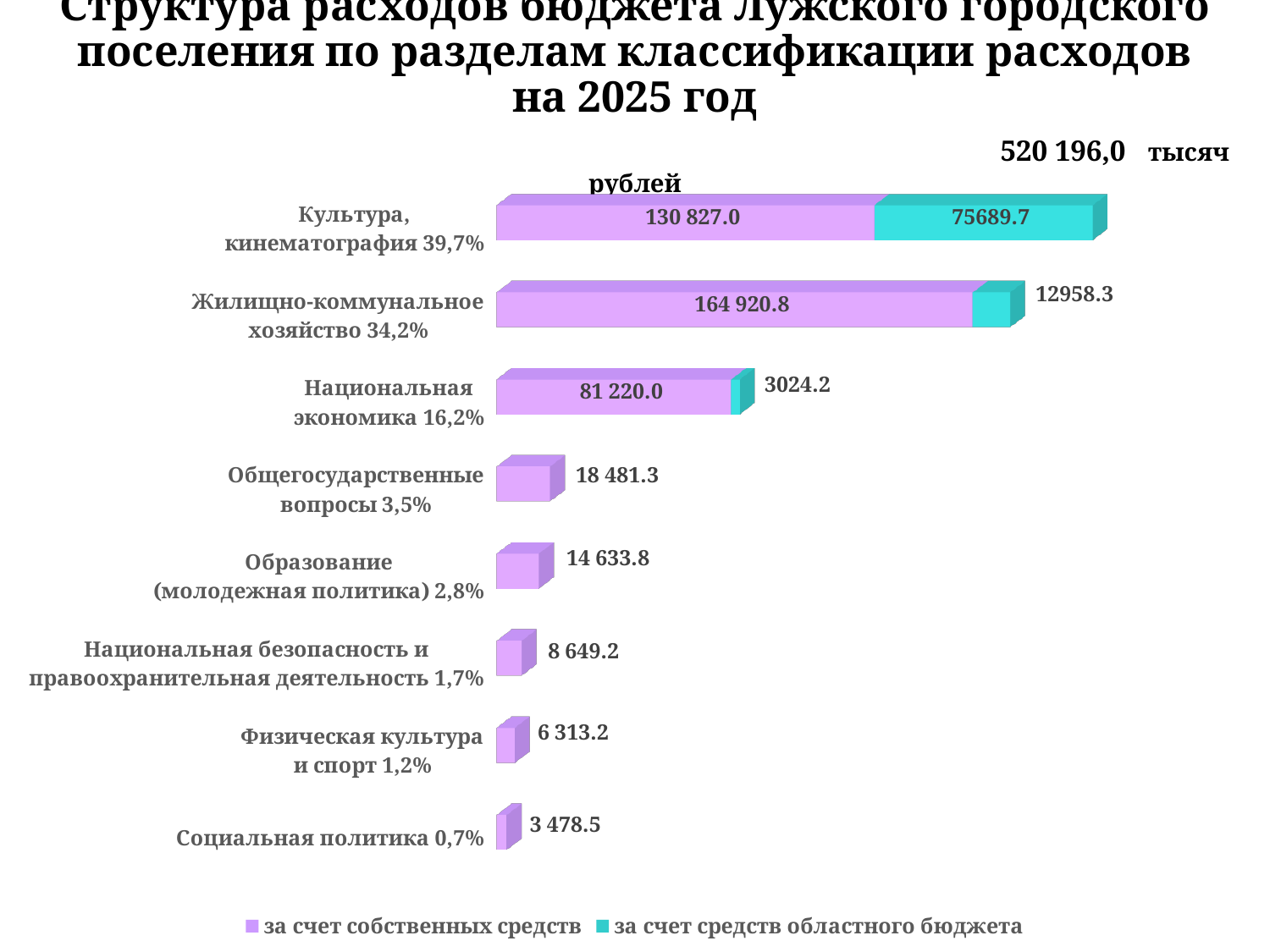
What is the value for 'за счет собственных средств' for Культура, кинематография? 130 827.0 What kind of chart is shown on the slide? Bar chart Which category has the lowest value on the chart? Социальная политика What is the value for 'за счет средств областного бюджета' for Жилищно-коммунальное хозяйство? 12958.3 Which category has the highest value for 'за счет собственных средств'? Жилищно-коммунальное хозяйство How many categories are shown on the chart? 8 What is the total of the stacked bar for Культура, кинематография? 206 516.7 Which is larger: the 'за счет средств областного бюджета' value for Культура, кинематография or for Жилищно-коммунальное хозяйство? Культура, кинематография How many series does the legend list? 2 What is the value shown for Социальная политика? 3 478.5 What is the difference between the 'за счет собственных средств' values for Жилищно-коммунальное хозяйство and Культура, кинематография? 34 093.8 What is the value for 'за счет средств областного бюджета' for Национальная экономика? 3024.2